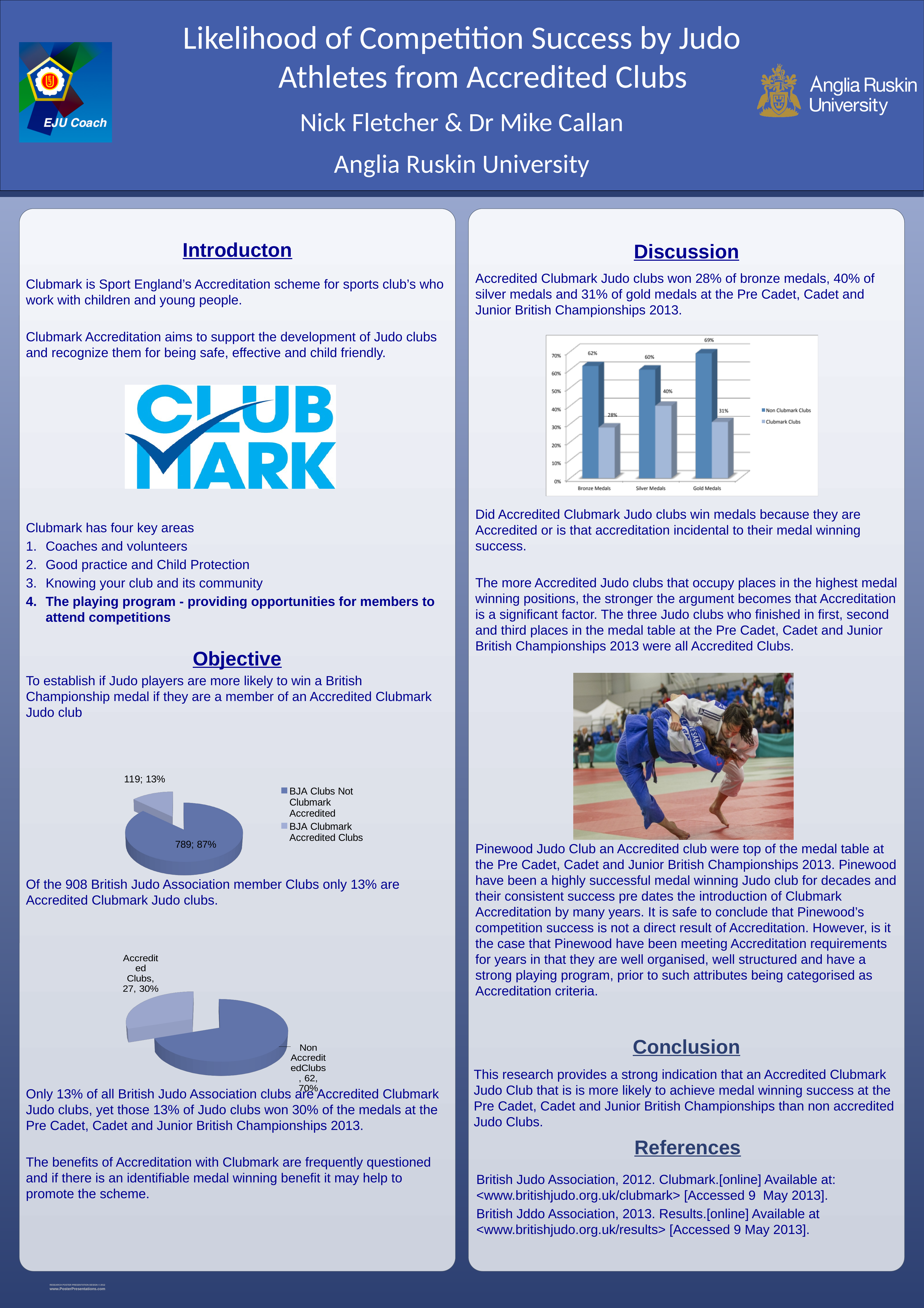
In the bar chart in the Discussion section, what percentage of gold medals did Non Clubmark Clubs win? 69% In the bar chart in the Discussion section, how many medal categories are shown on the x axis? 3 In the upper pie chart in the left column, how many BJA Clubs are Not Clubmark Accredited? 789 In the bar chart in the Discussion section, what percentage of bronze medals did Clubmark Clubs win? 28% What type of chart is used in the Discussion section to show medal percentages? Bar chart In the lower pie chart in the left column, which slice is larger, Accredited Clubs or Non Accredited Clubs? Non Accredited Clubs In the lower pie chart in the left column, how many medals were won by Non Accredited Clubs? 62 In the bar chart in the Discussion section, how many series does the legend list? 2 In the bar chart in the Discussion section, what is the value for Clubmark Clubs for Silver Medals? 40% In the upper pie chart in the left column, what share of the pie is BJA Clubmark Accredited Clubs? 13% In the bar chart in the Discussion section, for which medal category is the Non Clubmark Clubs value highest? Gold Medals In the bar chart in the Discussion section, what is the difference between the Non Clubmark Clubs and Clubmark Clubs values for Bronze Medals? 34%